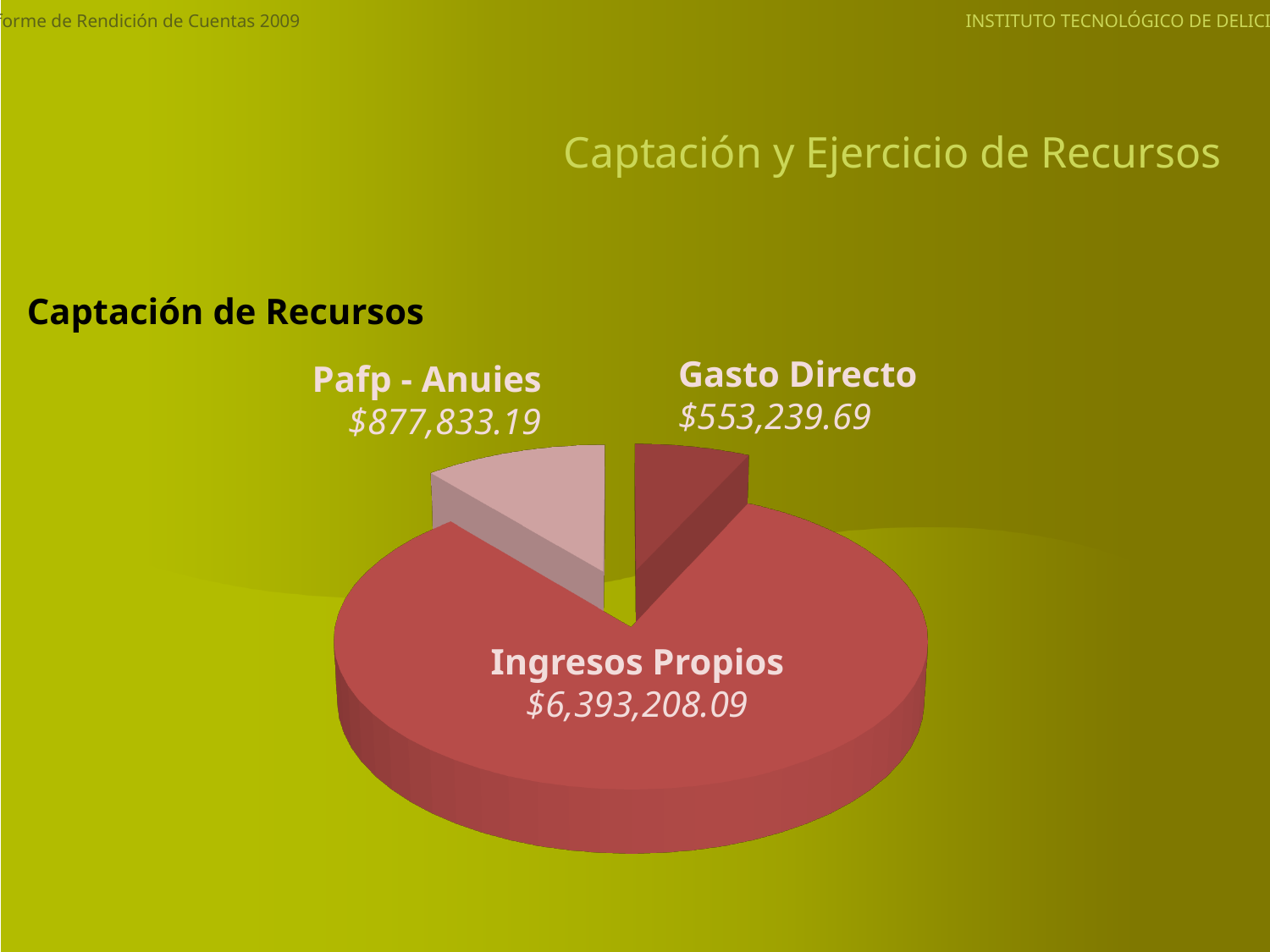
What kind of chart is shown on the slide? pie chart What is the value for Pafp - Anuies? $877,833.19 What is the heading shown above the pie chart? Captación de Recursos What is the value for Gasto Directo? $553,239.69 What is the difference between Ingresos Propios and Pafp - Anuies? $5,515,374.90 What is the total of all three slices in the pie chart? $7,824,280.97 What is the difference between Pafp - Anuies and Gasto Directo? $324,593.50 Which is larger, Pafp - Anuies or Gasto Directo? Pafp - Anuies What is the value for Ingresos Propios? $6,393,208.09 How many slices does the pie chart have? 3 Which category has the largest slice of the pie? Ingresos Propios Which category has the smallest slice of the pie? Gasto Directo